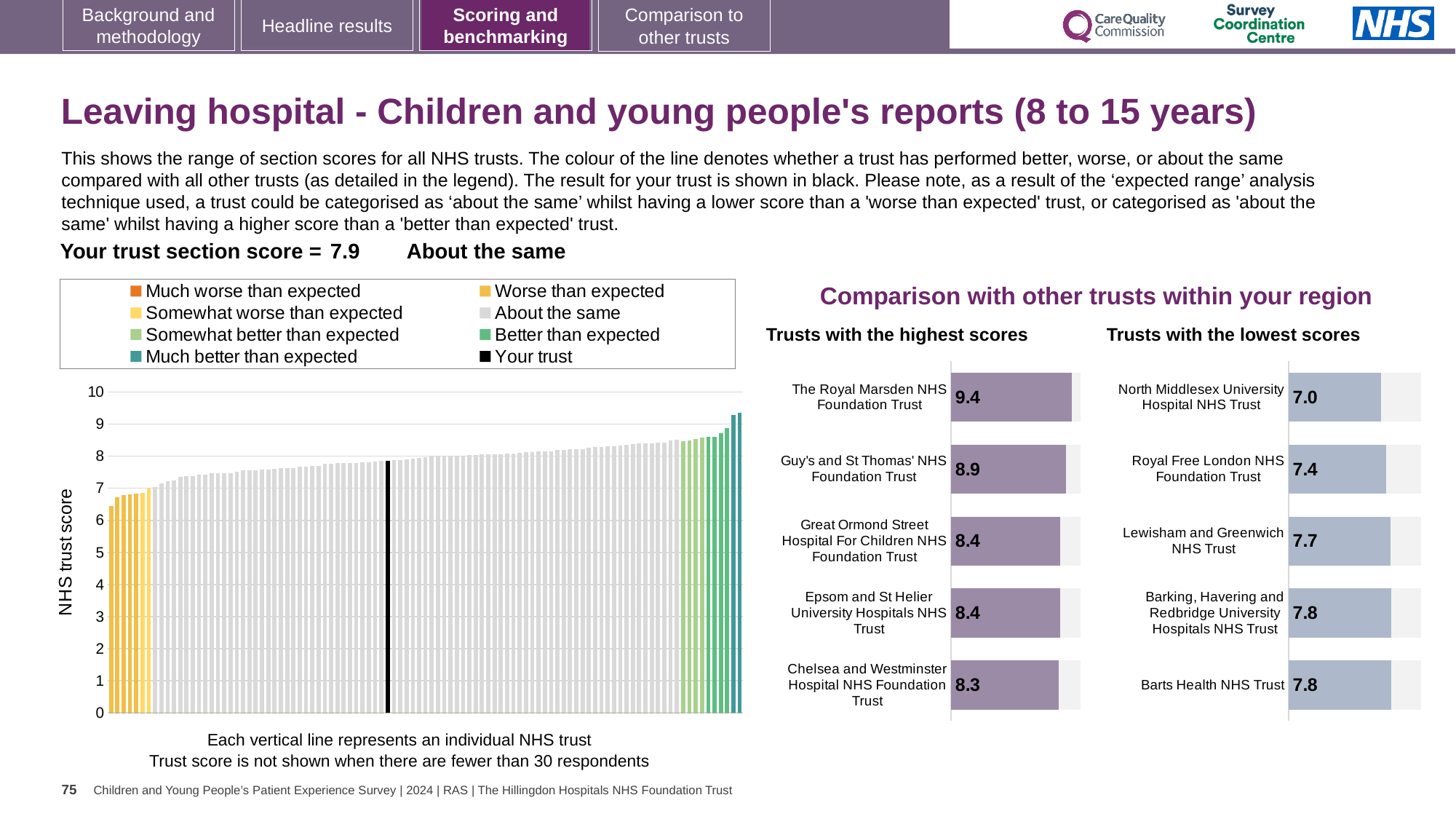
In the 'Trusts with the highest scores' chart, what is the score for The Royal Marsden NHS Foundation Trust? 9.4 In the 'Trusts with the highest scores' chart, which trust has the highest score? The Royal Marsden NHS Foundation Trust In the main chart on the left, what is the section score for your trust (the black bar)? 7.9 In the 'Trusts with the highest scores' chart, what is the score for Guy's and St Thomas' NHS Foundation Trust? 8.9 How many trusts are shown in the 'Trusts with the highest scores' chart? 5 How many entries does the legend of the main chart on the left list? 8 In the main chart on the left, do the trust scores rise or fall from left to right? rise In the 'Trusts with the highest scores' chart, what is the difference between the scores of The Royal Marsden NHS Foundation Trust and Chelsea and Westminster Hospital NHS Foundation Trust? 1.1 In the 'Trusts with the lowest scores' chart, what is the difference between the scores of Barts Health NHS Trust and North Middlesex University Hospital NHS Trust? 0.8 In the 'Trusts with the lowest scores' chart, what is the score for North Middlesex University Hospital NHS Trust? 7.0 In the 'Trusts with the lowest scores' chart, which trust has the lowest score? North Middlesex University Hospital NHS Trust In the 'Trusts with the lowest scores' chart, which has the larger score: Royal Free London NHS Foundation Trust or Lewisham and Greenwich NHS Trust? Lewisham and Greenwich NHS Trust